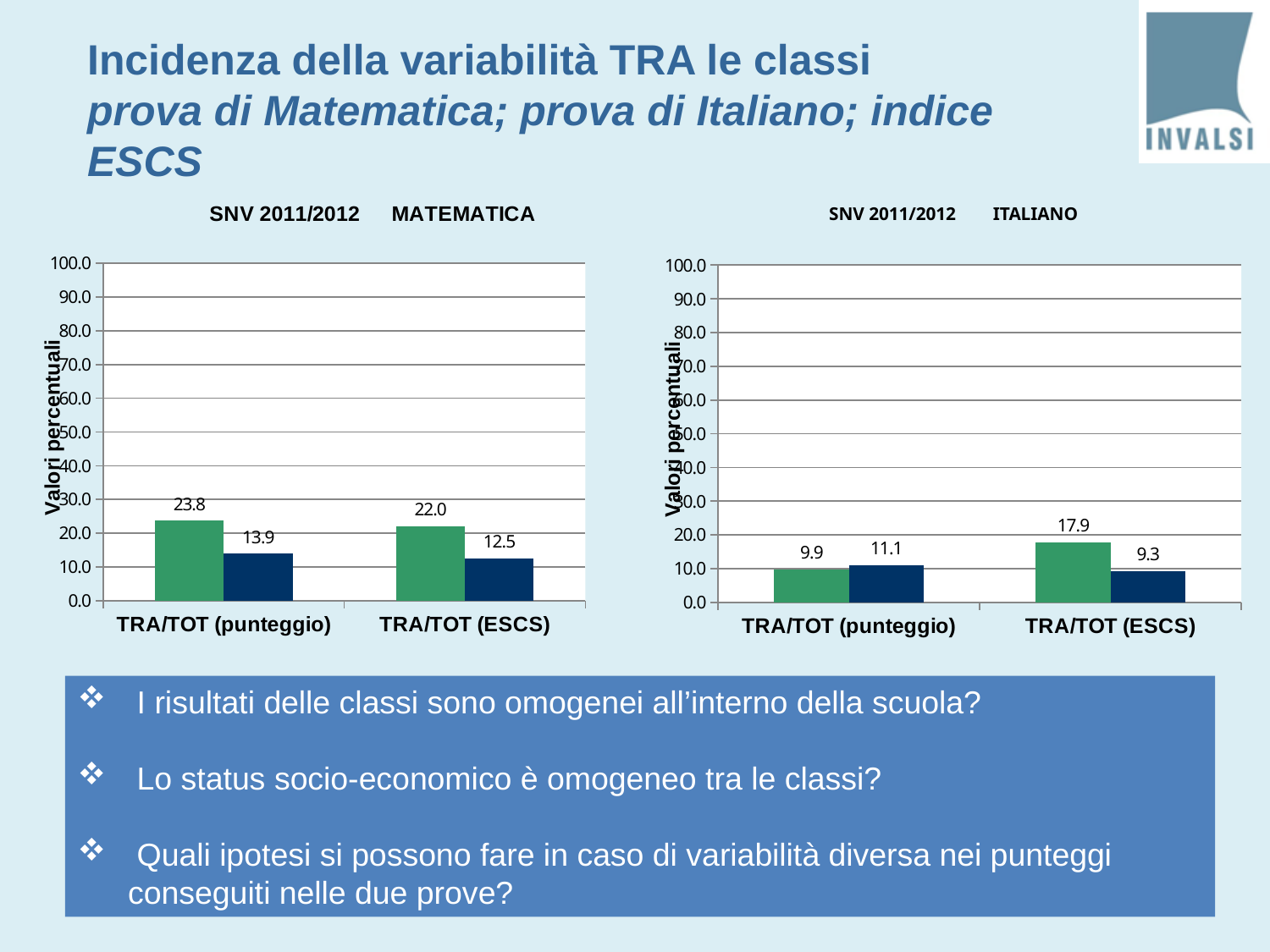
In the ITALIANO chart, which bar has the lowest value? Dark blue bar for TRA/TOT (ESCS), 9.3 In the MATEMATICA chart, what is the value of the green bar for TRA/TOT (punteggio)? 23.8 In the MATEMATICA chart, which bar has the highest value? Green bar for TRA/TOT (punteggio), 23.8 In the ITALIANO chart, what is the difference between the green and dark blue bars for TRA/TOT (ESCS)? 8.6 In the MATEMATICA chart, what is the value of the dark blue bar for TRA/TOT (ESCS)? 12.5 In the MATEMATICA chart, what is the difference between the green and dark blue bars for TRA/TOT (punteggio)? 9.9 In the MATEMATICA chart, is the green bar for TRA/TOT (ESCS) greater or less than 20.0? greater How many categories are shown on the x axis of the ITALIANO chart? 2 In the ITALIANO chart, what is the value of the green bar for TRA/TOT (ESCS)? 17.9 What type of chart is the MATEMATICA chart? Bar chart In the ITALIANO chart, what is the value of the dark blue bar for TRA/TOT (punteggio)? 11.1 In the ITALIANO chart, which bar is larger for TRA/TOT (punteggio), the green or the dark blue one? dark blue